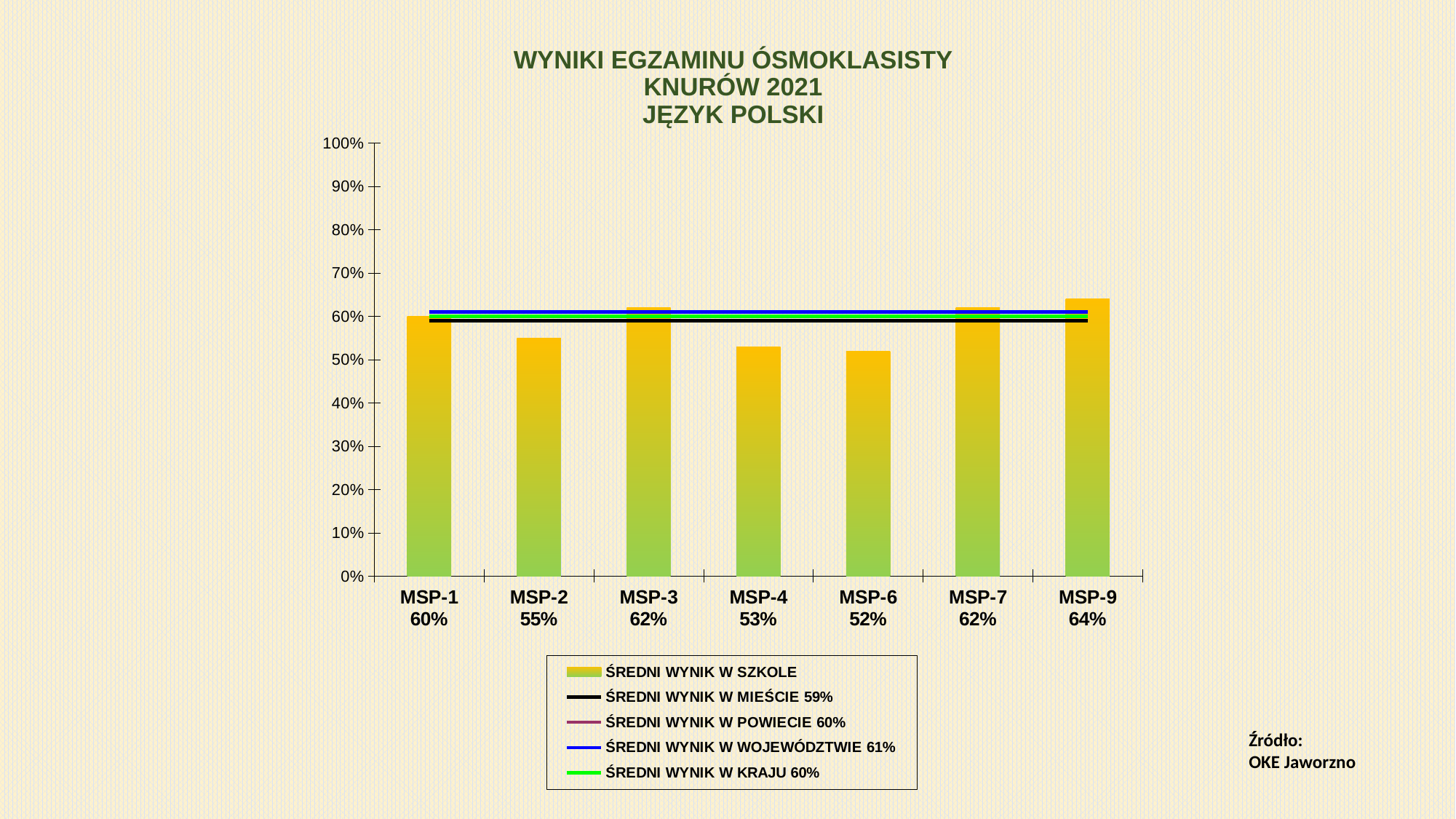
How many series does the legend list? 5 What is the average school result for MSP-1? 60% What kind of chart is this? combination bar and line chart What is the average school result for MSP-4? 53% Which school has a higher result, MSP-2 or MSP-7? MSP-7 What is the average result in the voivodeship (ŚREDNI WYNIK W WOJEWÓDZTWIE) according to the legend? 61% What is the title of the chart? WYNIKI EGZAMINU ÓSMOKLASISTY KNURÓW 2021 JĘZYK POLSKI How many schools are shown on the chart? 7 Which school has the lowest average result? MSP-6 What is the difference between the results of MSP-9 and MSP-6? 12% Which school has the highest average result? MSP-9 What is the average result in the city (ŚREDNI WYNIK W MIEŚCIE) according to the legend? 59%